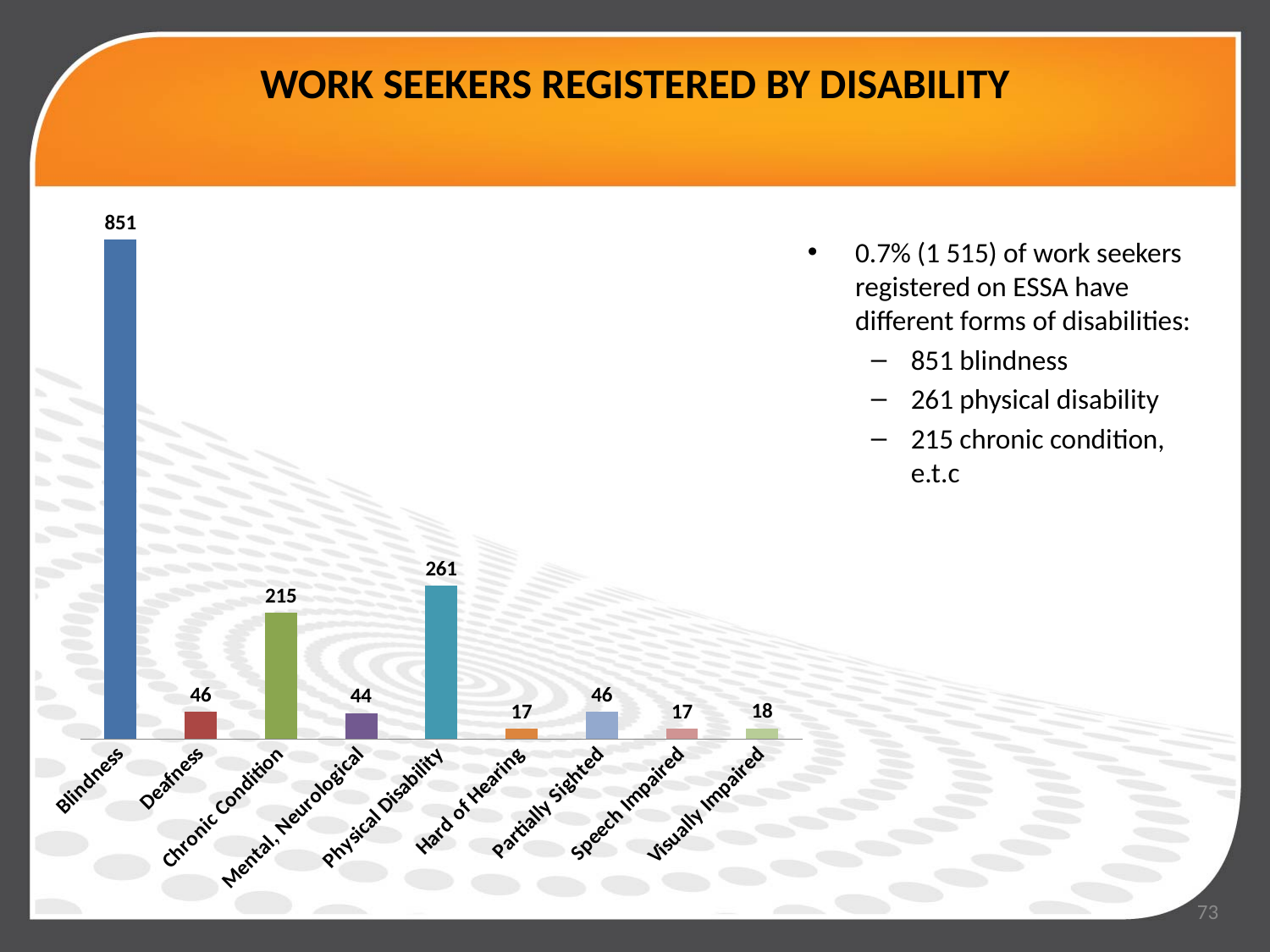
What is the title of the chart? WORK SEEKERS REGISTERED BY DISABILITY What is the value for Blindness? 851 What is the value for Chronic Condition? 215 Which is larger, the value for Deafness or the value for Mental, Neurological? Deafness What is the difference between the values for Physical Disability and Chronic Condition? 46 Which category has the highest value? Blindness What is the value for Visually Impaired? 18 What kind of chart is shown on the slide? bar chart What is the difference between the values for Blindness and Physical Disability? 590 How many disability categories are shown in the chart? 9 What is the value for Physical Disability? 261 What is the value for Mental, Neurological? 44